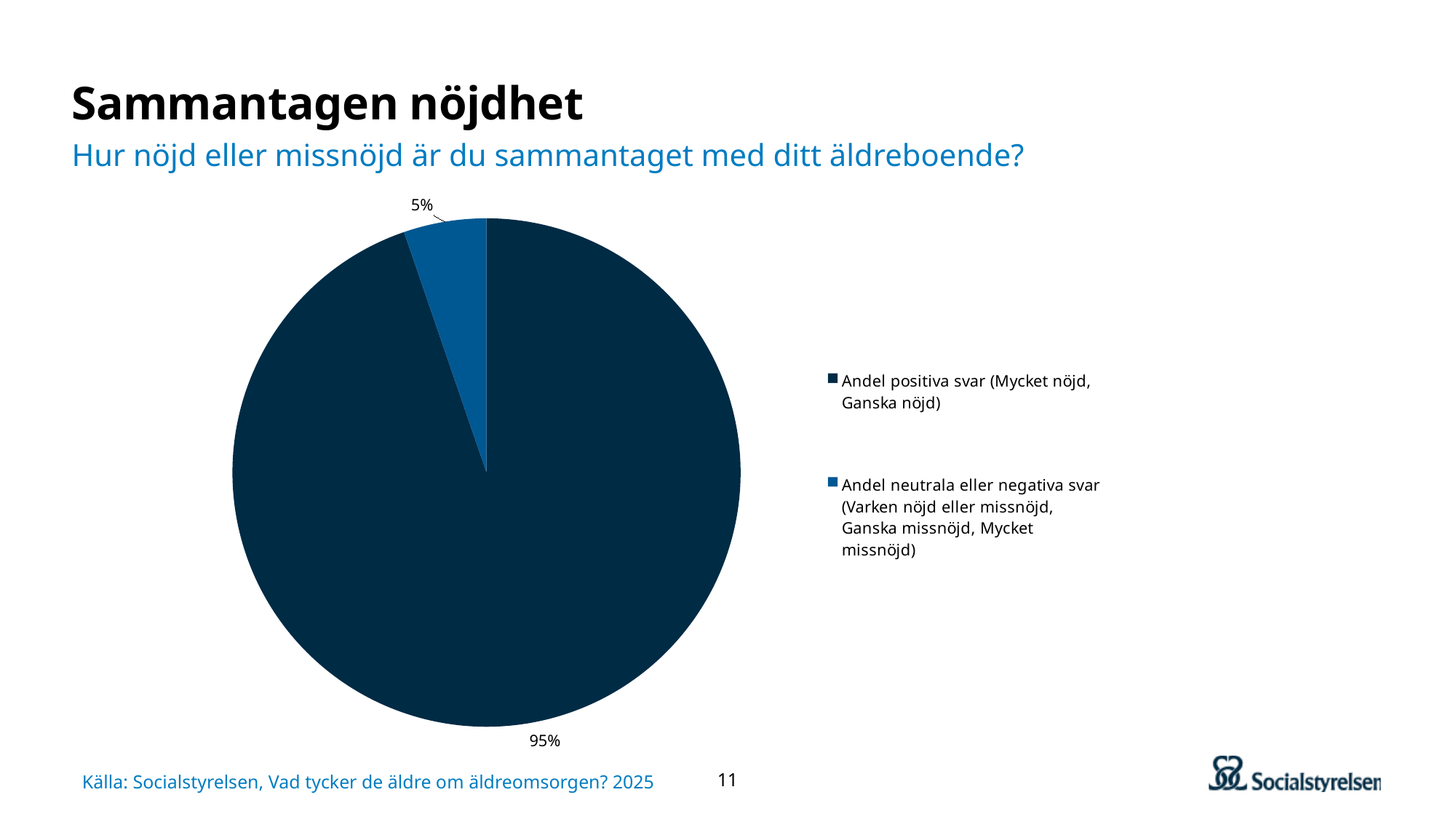
Which slice of the pie is the smallest? Andel neutrala eller negativa svar (Varken nöjd eller missnöjd, Ganska missnöjd, Mycket missnöjd) How many slices does the pie chart have? 2 What kind of chart is shown on the slide? pie chart Which is larger: the share of positive answers or the share of neutral or negative answers? Andel positiva svar (Mycket nöjd, Ganska nöjd) Which slice of the pie is the largest? Andel positiva svar (Mycket nöjd, Ganska nöjd) How many entries does the legend list? 2 What is the difference in percentage points between the positive slice and the neutral or negative slice? 90 percentage points What is the total of the two slices shown in the pie chart? 100% What question is the chart based on, as shown in the subtitle? Hur nöjd eller missnöjd är du sammantaget med ditt äldreboende? What share of the pie is 'Andel neutrala eller negativa svar (Varken nöjd eller missnöjd, Ganska missnöjd, Mycket missnöjd)'? 5% What is the source cited below the chart? Socialstyrelsen, Vad tycker de äldre om äldreomsorgen? 2025 What share of the pie is 'Andel positiva svar (Mycket nöjd, Ganska nöjd)'? 95%